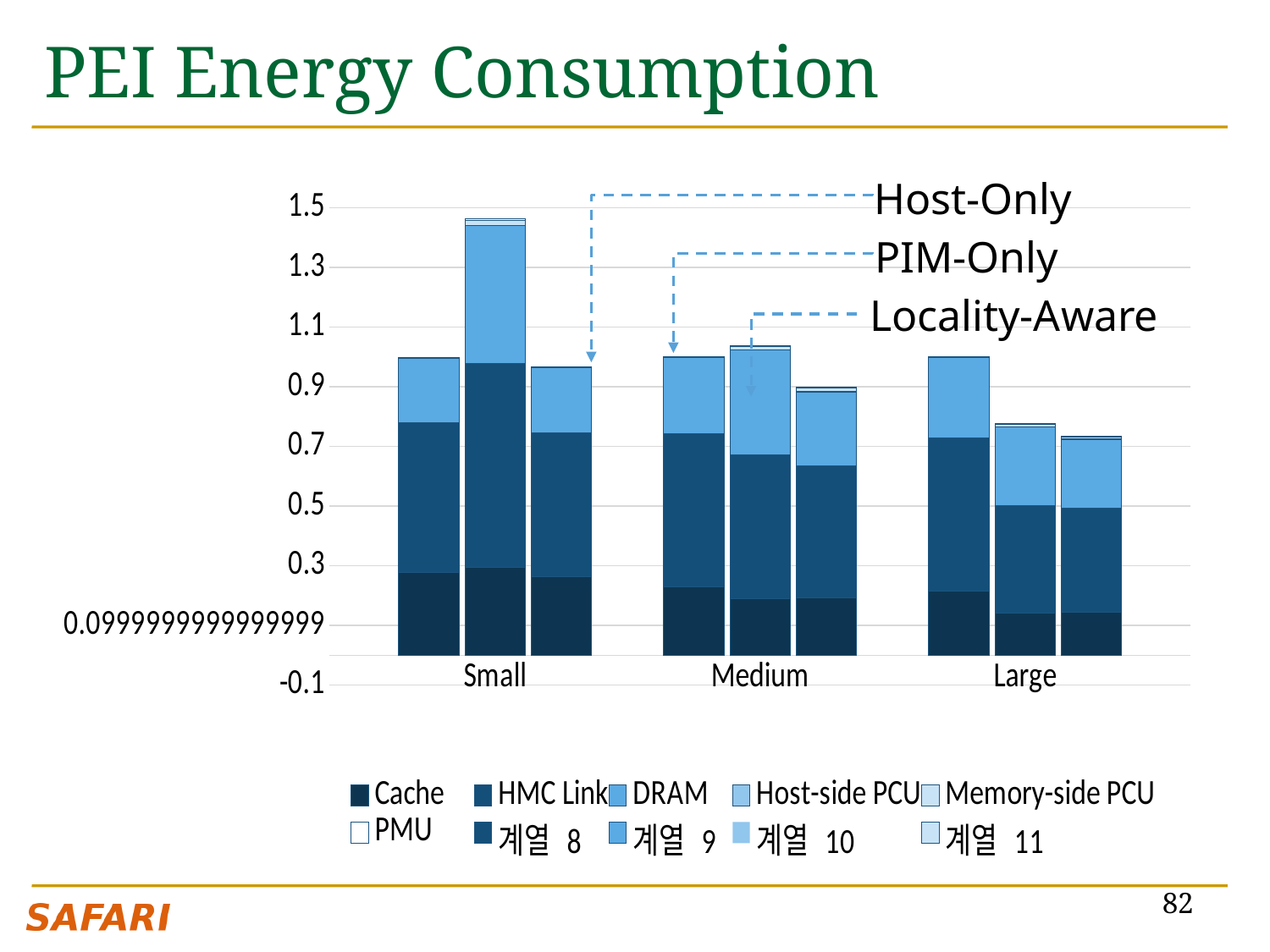
Do the PIM-Only bar totals rise or fall from Small to Large? fall Is the total of the PIM-Only bar for Large greater or less than 0.9? less Which is taller: the PIM-Only bar for Small or the PIM-Only bar for Medium? PIM-Only for Small Which of the three bars in the Small group is the tallest? PIM-Only How many series does the legend list? 10 What kind of chart is shown on the slide? stacked bar chart How many categories are shown on the x axis? 3 Is the total of the PIM-Only bar for Small greater or less than 1.3? greater Which of the three bars in the Large group is the tallest? Host-Only Is the total of the Locality-Aware bar for Small greater or less than 1.1? less Which is taller: the Locality-Aware bar for Medium or the Locality-Aware bar for Large? Locality-Aware for Medium What is the title of the chart? PEI Energy Consumption